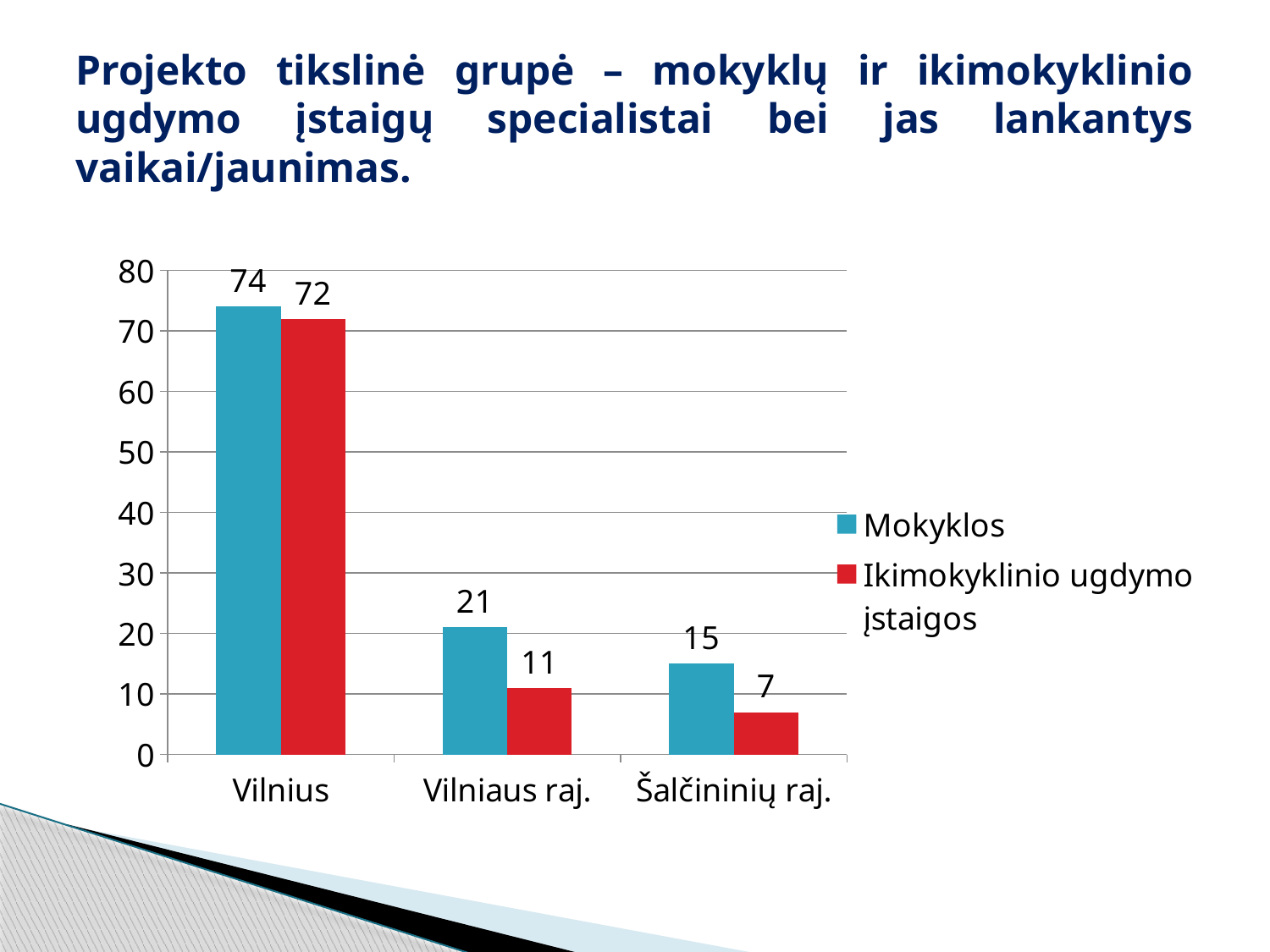
How many series does the legend list? 2 What is the difference between Mokyklos and Ikimokyklinio ugdymo įstaigos in Vilniaus raj.? 10 Which category has the highest value for Ikimokyklinio ugdymo įstaigos? Vilnius What is the value for Mokyklos in Šalčininių raj.? 15 What is the value for Ikimokyklinio ugdymo įstaigos in Vilniaus raj.? 11 Which is larger in Šalčininių raj.: Mokyklos or Ikimokyklinio ugdymo įstaigos? Mokyklos What is the value for Mokyklos in Vilnius? 74 What kind of chart is shown on the slide? Bar chart What is the difference between the Mokyklos values for Vilnius and Šalčininių raj.? 59 Which category has the lowest value for Mokyklos? Šalčininių raj. Do the Mokyklos values rise or fall from Vilnius to Šalčininių raj.? Fall How many categories are shown on the x axis? 3